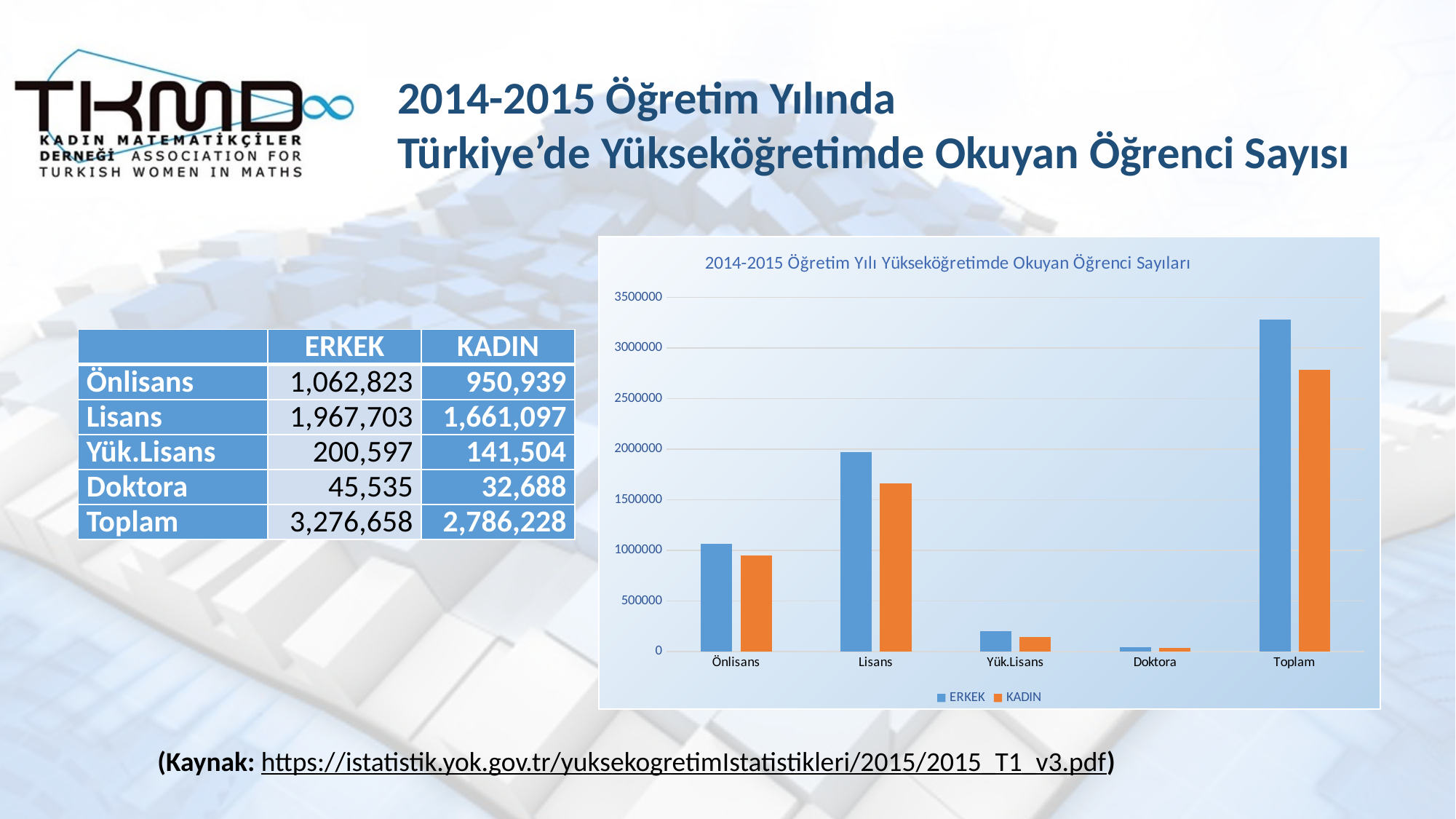
Excluding Toplam, which category has the highest KADIN value? Lisans What kind of chart is shown on the slide? bar chart What is the title of the chart? 2014-2015 Öğretim Yılı Yükseköğretimde Okuyan Öğrenci Sayıları What is the difference between the ERKEK and KADIN values for Doktora? 12,847 How many categories are shown on the x axis of the chart? 5 What is the ERKEK value for Lisans? 1,967,703 Is the ERKEK value for Toplam greater or less than 3000000? greater Which is larger for Yük.Lisans, the ERKEK value or the KADIN value? ERKEK Which category has the lowest ERKEK value? Doktora How many series does the chart legend list? 2 What is the KADIN value for Önlisans? 950,939 What is the KADIN value for Toplam? 2,786,228